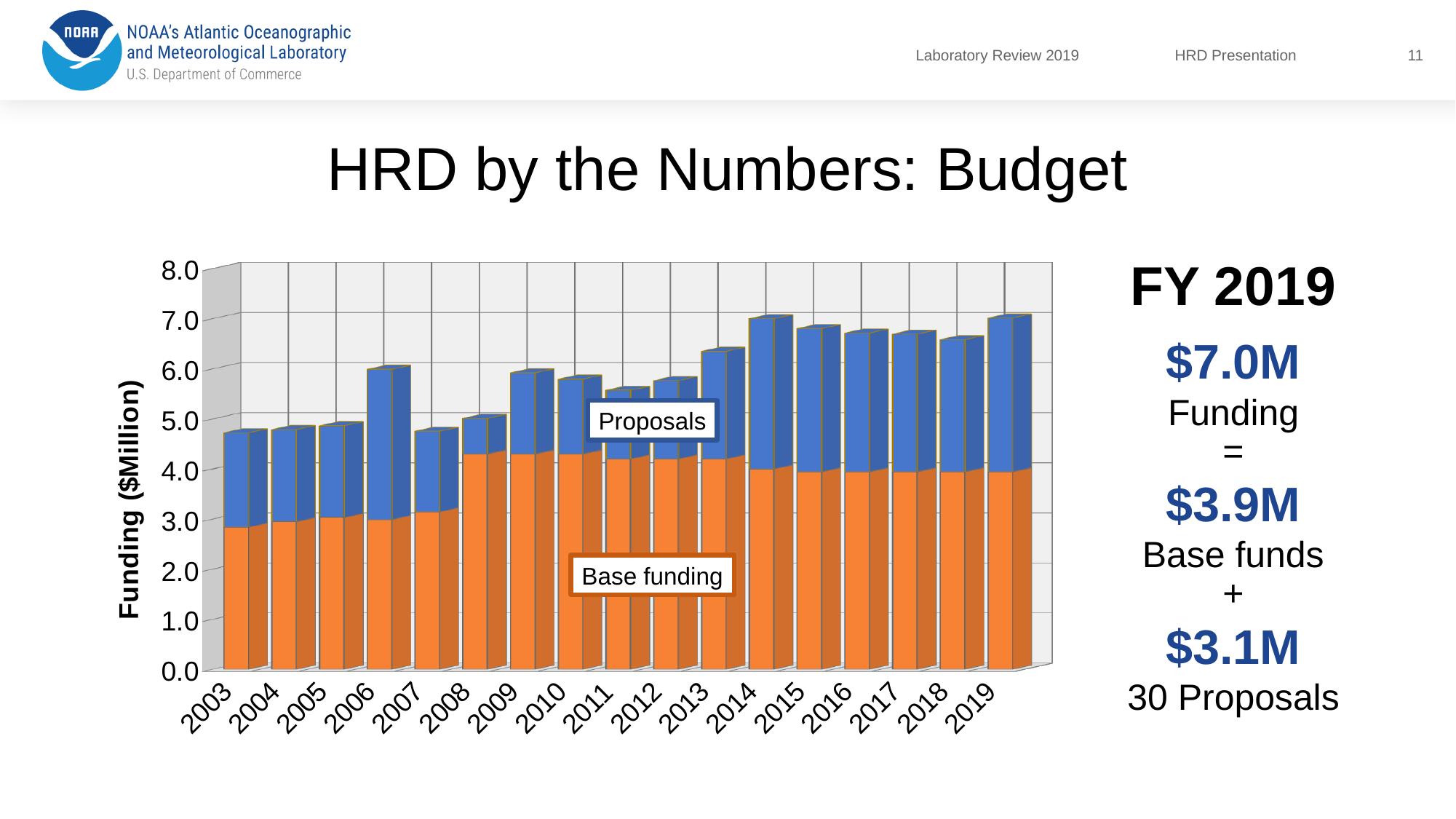
Is the base funding for 2008 greater or less than 4.0? greater What is the label of the y axis? Funding ($Million) What is the proposals funding for FY 2019? $3.1M What is the base funding for FY 2019? $3.9M Is the total funding for 2014 greater or less than 6.0? greater How many years are shown on the x axis of the chart? 17 Which year has higher total funding, 2006 or 2007? 2006 What is the total funding for FY 2019? $7.0M What kind of chart is shown on the slide? bar chart How many series are plotted in the chart? 2 Is the total funding for 2003 greater or less than 5.0? less Does base funding rise or fall from 2003 to 2008? rise